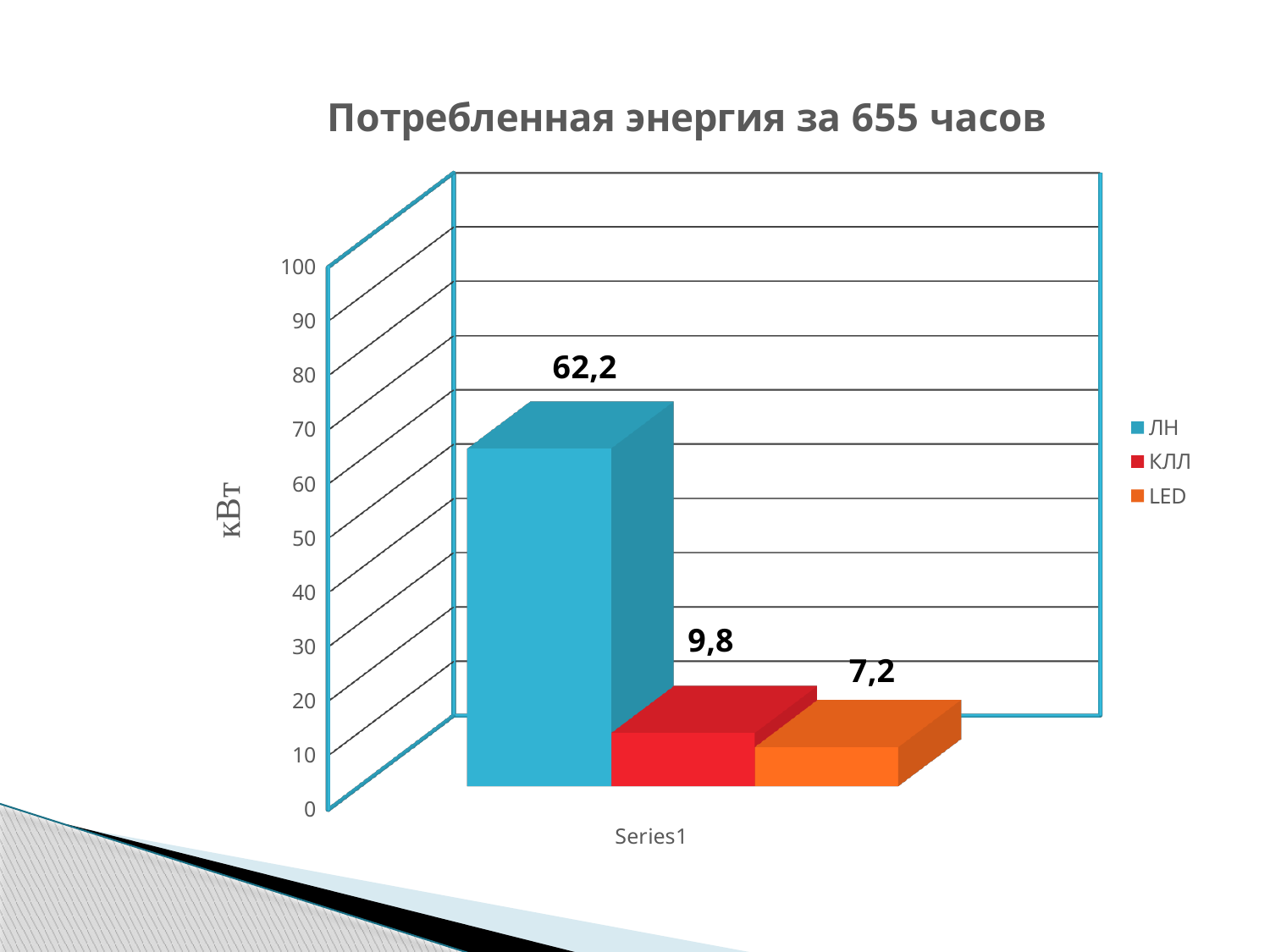
Which series has the lowest value? LED What is the difference between the values for ЛН and КЛЛ? 52,4 Which series has the highest value? ЛН Is the value for ЛН greater or less than 50? greater What is the value for ЛН? 62,2 What is the value for LED? 7,2 What is the difference between the values for КЛЛ and LED? 2,6 How many series does the legend list? 3 What is the title of the chart? Потребленная энергия за 655 часов What kind of chart is shown on the slide? bar chart Which is larger, the value for КЛЛ or the value for LED? КЛЛ What is the value for КЛЛ? 9,8